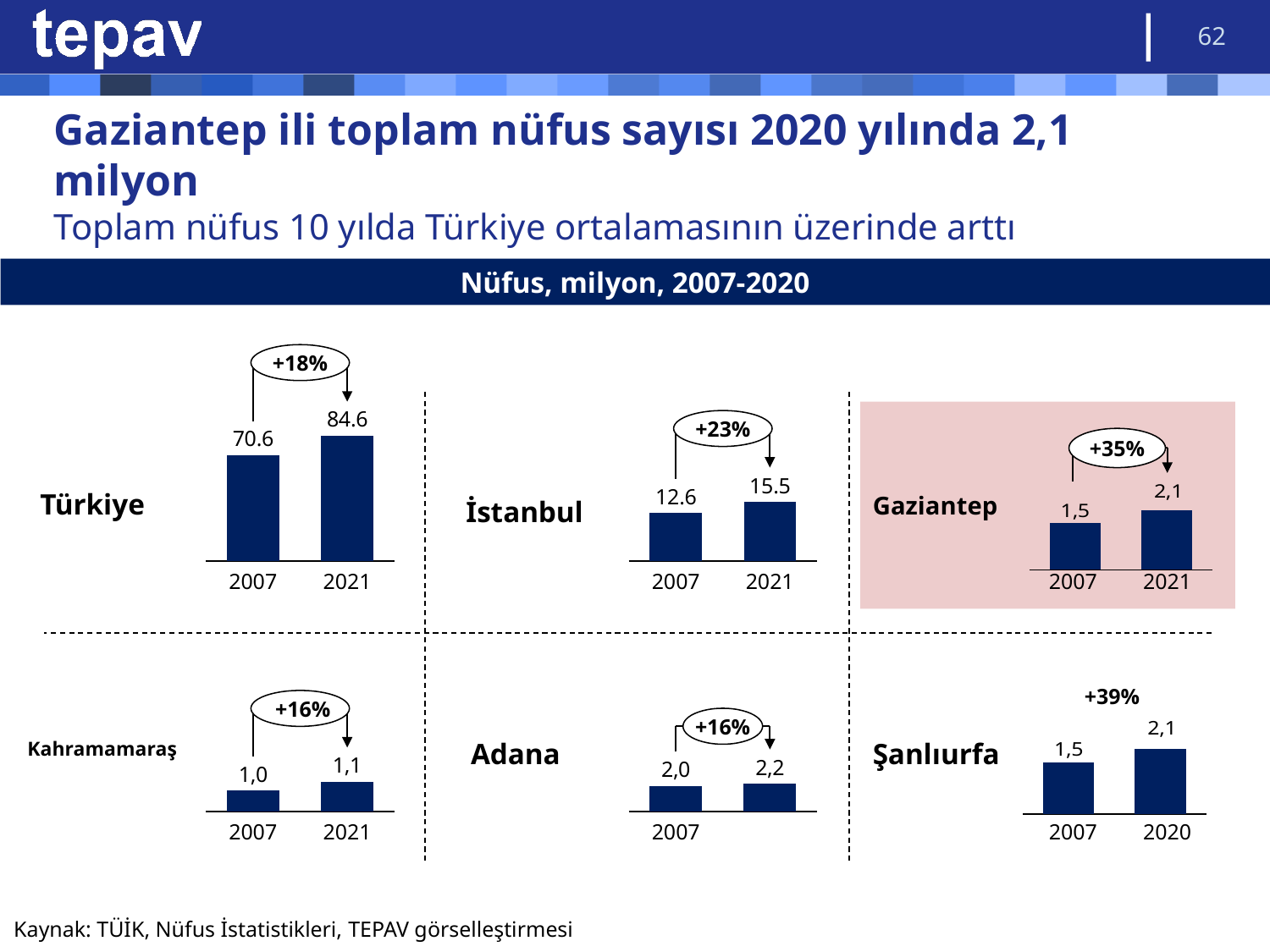
What type of chart is used for each region on the slide? Bar chart In the Gaziantep chart, what is the value shown for 2007? 1,5 In the Türkiye chart, what is the population value shown for 2007? 70.6 In the İstanbul chart, what is the value shown for 2021? 15.5 In the Türkiye chart, what is the difference between the 2021 and 2007 values? 14.0 In the Türkiye chart, what is the population value shown for 2021? 84.6 In the İstanbul chart, what is the difference between the 2021 and 2007 values? 2.9 In the Şanlıurfa chart, what is the value shown for 2020? 2,1 What percentage change is shown above the Gaziantep chart? +35% In the Şanlıurfa chart, do the values rise or fall from 2007 to 2020? Rise In the Adana chart, what is the value shown for 2007? 2,0 In the Kahramanmaraş chart, which year has the higher value, 2007 or 2021? 2021